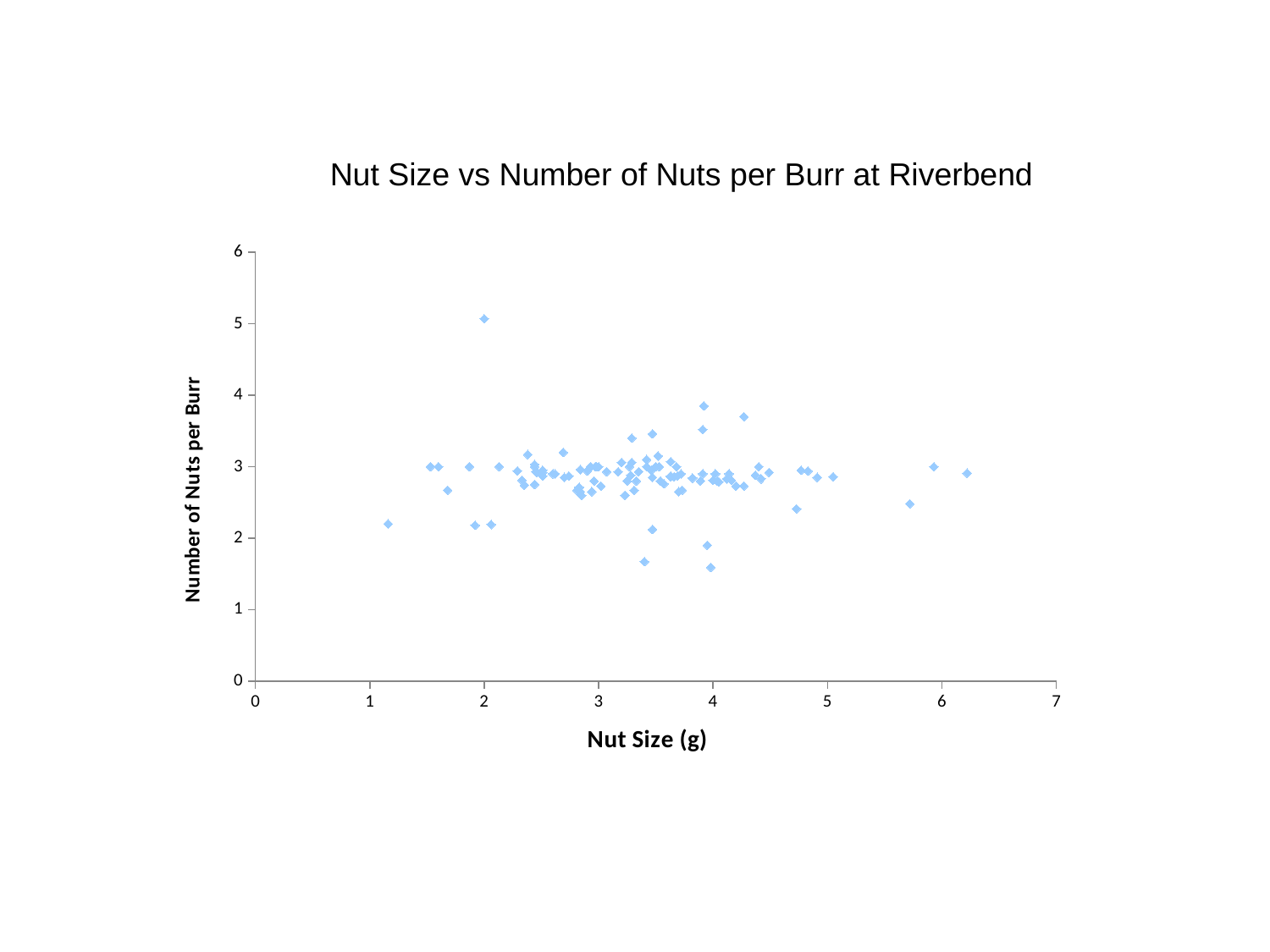
Is the nut size of the leftmost point on the chart greater or less than 2 g? less Is the number of nuts per burr for the rightmost point greater or less than 2? greater Is the nut size of the highest point on the chart greater or less than 3 g? less What kind of chart is shown on the slide? Scatter plot Does the number of nuts per burr clearly rise, clearly fall, or stay roughly flat as nut size increases? Roughly flat What is the title of the chart? Nut Size vs Number of Nuts per Burr at Riverbend What is the label of the x axis? Nut Size (g)